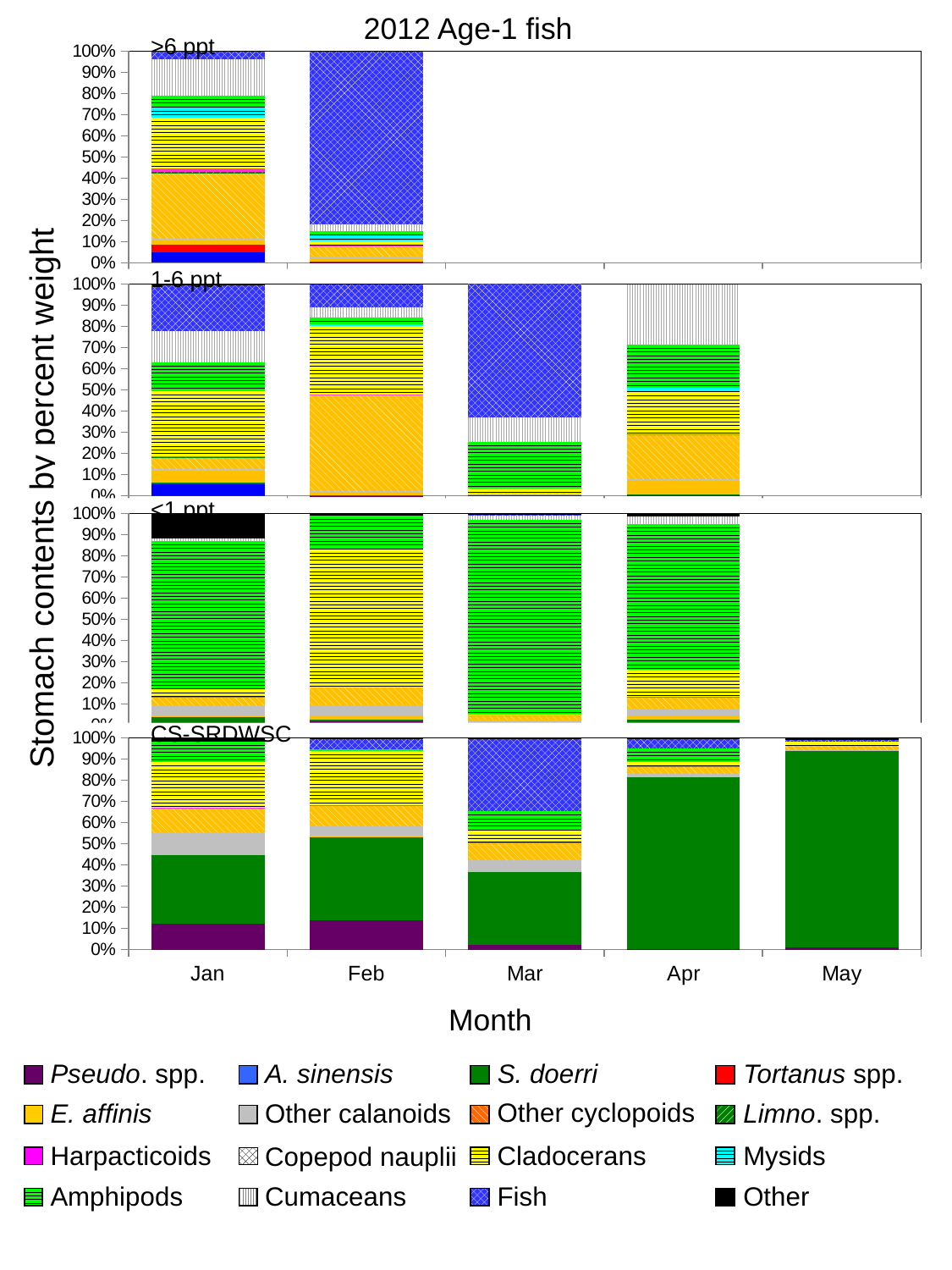
In the "CS-SRDWSC" panel, is the Pseudo. spp. share of the Jan bar greater or less than 20%? less What is the y-axis label of the chart? Stomach contents by percent weight What is the overall title of the chart? 2012 Age-1 fish In the "1-6 ppt" panel, how many months have a bar plotted? 4 In the "CS-SRDWSC" panel, is the S. doerri share larger in Jan or in May? May How many months are shown on the x axis? 5 In the ">6 ppt" panel, is the Fish share of the Feb bar greater or less than 50%? greater In the ">6 ppt" panel, how many months have a bar plotted? 2 How many series does the legend list? 16 In the "CS-SRDWSC" panel, is the S. doerri share of the May bar greater or less than 80%? greater What kind of chart is shown on the slide? stacked bar chart